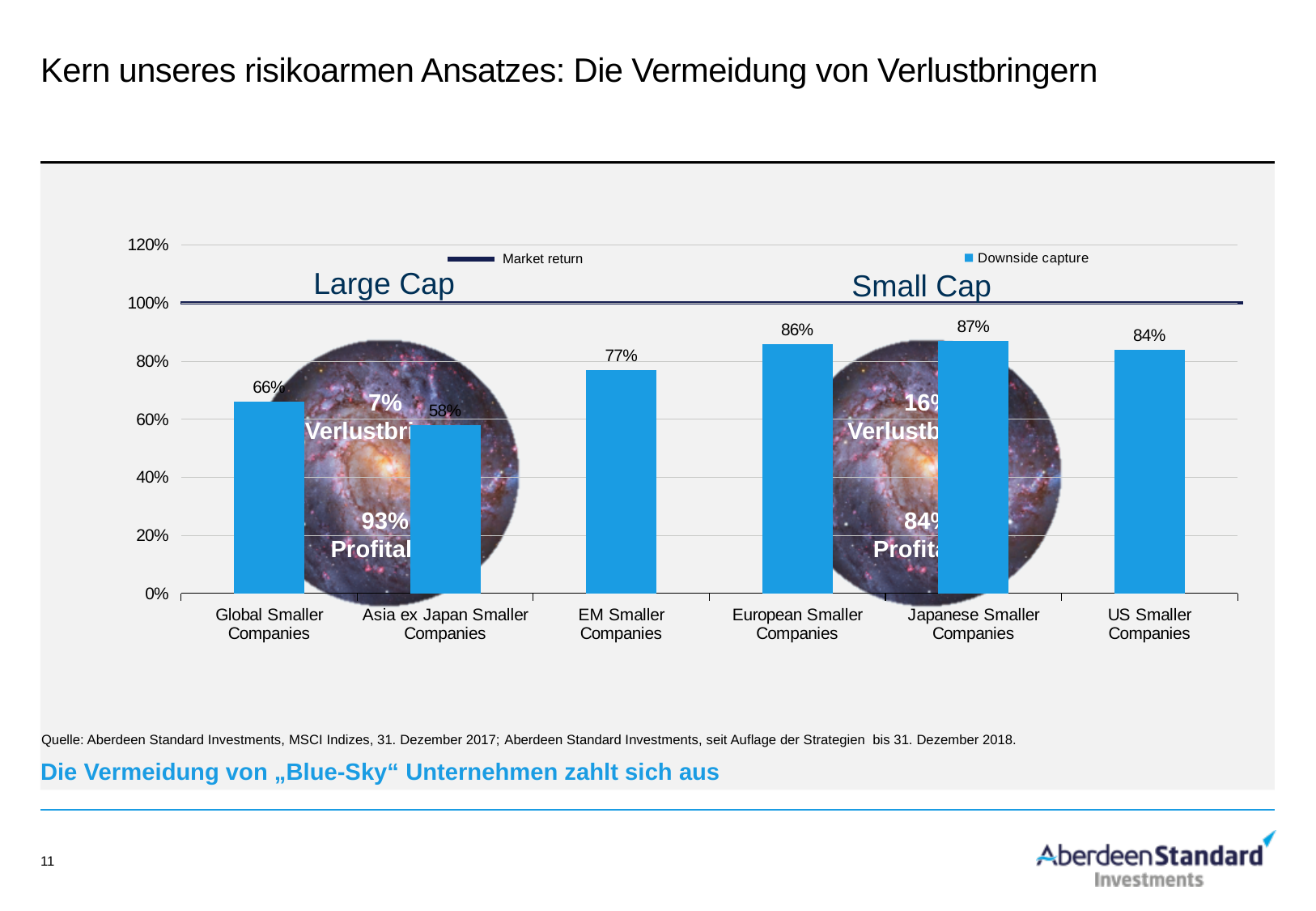
Is the downside capture value for Asia ex Japan Smaller Companies greater or less than 60%? less Which category has the highest downside capture value? Japanese Smaller Companies Which category has the lowest downside capture value? Asia ex Japan Smaller Companies How many categories are shown on the x axis of the chart? 6 What is the downside capture value for US Smaller Companies? 84% Which has a higher downside capture value, EM Smaller Companies or Global Smaller Companies? EM Smaller Companies What kind of chart is shown on the slide? bar chart How many series does the chart legend list? 2 What is the downside capture value for EM Smaller Companies? 77% At what level is the Market return line drawn on the chart? 100% What is the downside capture value for Global Smaller Companies? 66% What is the difference between the downside capture values for European Smaller Companies and Asia ex Japan Smaller Companies? 28%